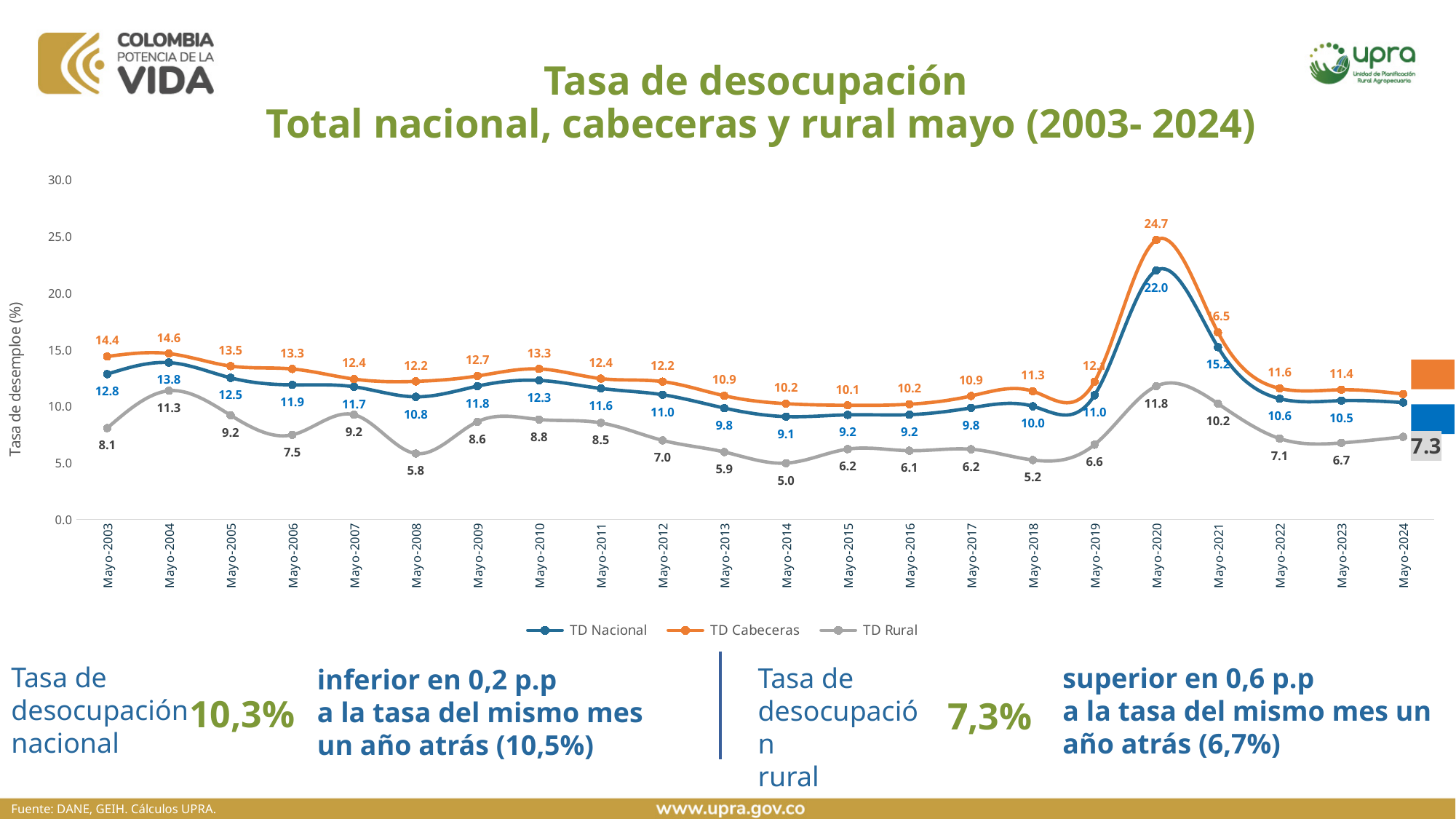
What is the value of TD Rural for Mayo-2014? 5.0 Does TD Nacional rise or fall from Mayo-2020 to Mayo-2023? fall What is the value of TD Nacional for Mayo-2004? 13.8 Which is larger for TD Rural: the value in Mayo-2004 or in Mayo-2021? Mayo-2004 How many time points are plotted on the x axis? 22 What kind of chart is shown on the slide? line chart In which month-year does TD Rural reach its lowest value? Mayo-2014 How many series does the legend list? 3 In which month-year does TD Cabeceras reach its highest value? Mayo-2020 Is the value of TD Nacional for Mayo-2020 greater or less than 20.0? greater What is the difference between TD Cabeceras and TD Nacional in Mayo-2020? 2.7 What is the value of TD Cabeceras for Mayo-2020? 24.7